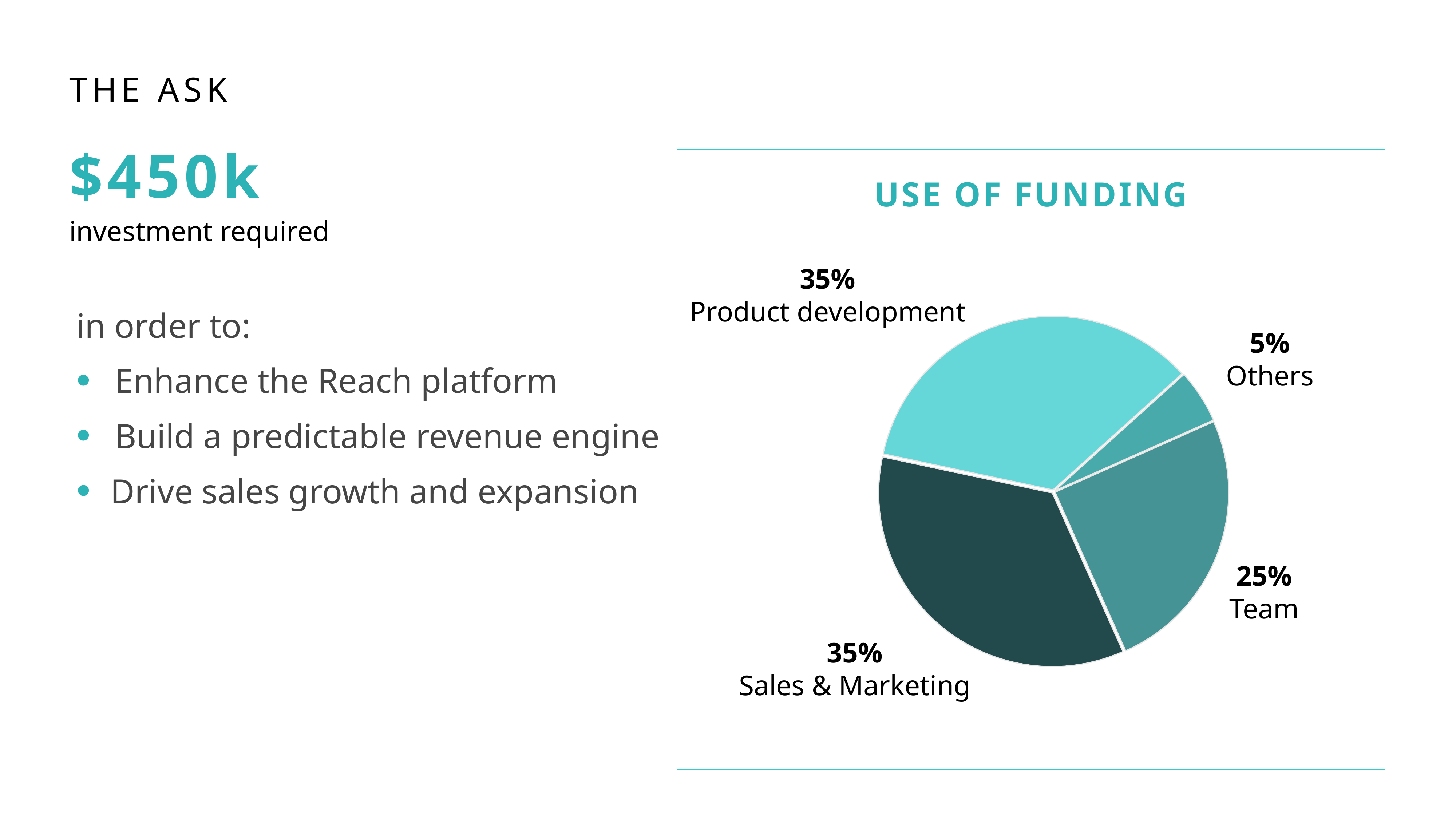
What is the title of the chart? USE OF FUNDING What share of funding goes to Others? 5% What kind of chart is shown on the slide? Pie chart How many slices does the pie chart have? 4 What is the difference between the Team share and the Others share? 20% What share of funding goes to Team? 25% Which is larger, the share for Team or the share for Others? Team Which category receives the smallest share of funding? Others What share of funding goes to Product development? 35% What is the combined share of Product development and Sales & Marketing? 70% What is the difference between the Product development share and the Team share? 10% What share of funding goes to Sales & Marketing? 35%